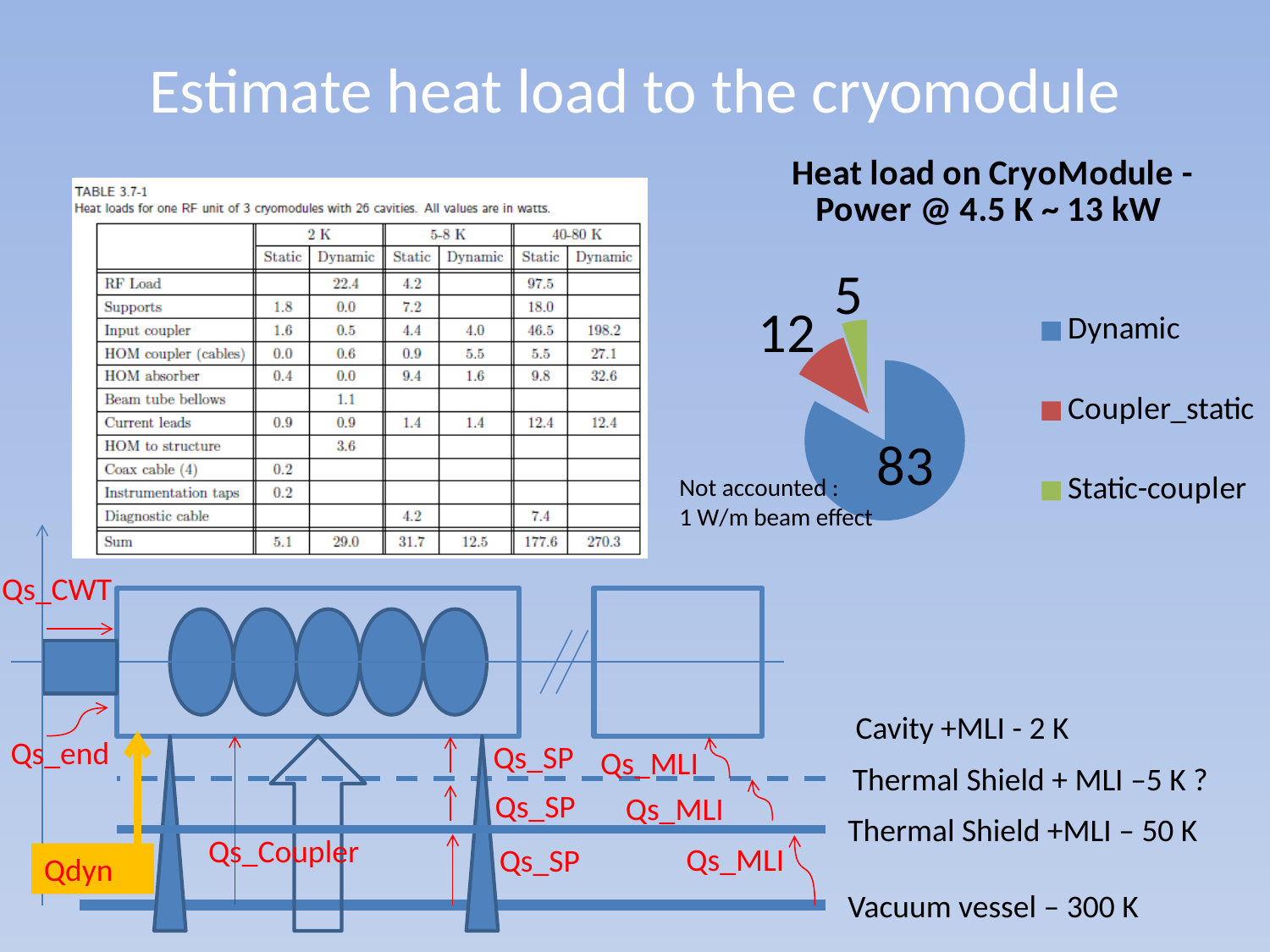
Which slice of the pie chart is the largest? Dynamic What kind of chart is shown on the slide? pie chart What is the difference between the Dynamic and Coupler_static values in the pie chart? 71 What is the value of the Coupler_static slice in the pie chart? 12 What is the title of the pie chart? Heat load on CryoModule - Power @ 4.5 K ~ 13 kW What share of the pie chart does the Dynamic slice represent? 83% Which slice of the pie chart is the smallest? Static-coupler Which is larger in the pie chart, Coupler_static or Static-coupler? Coupler_static What is the total of all the slice values in the pie chart? 100 What is the value of the Static-coupler slice in the pie chart? 5 How many slices does the pie chart have? 3 What is the value of the Dynamic slice in the pie chart? 83